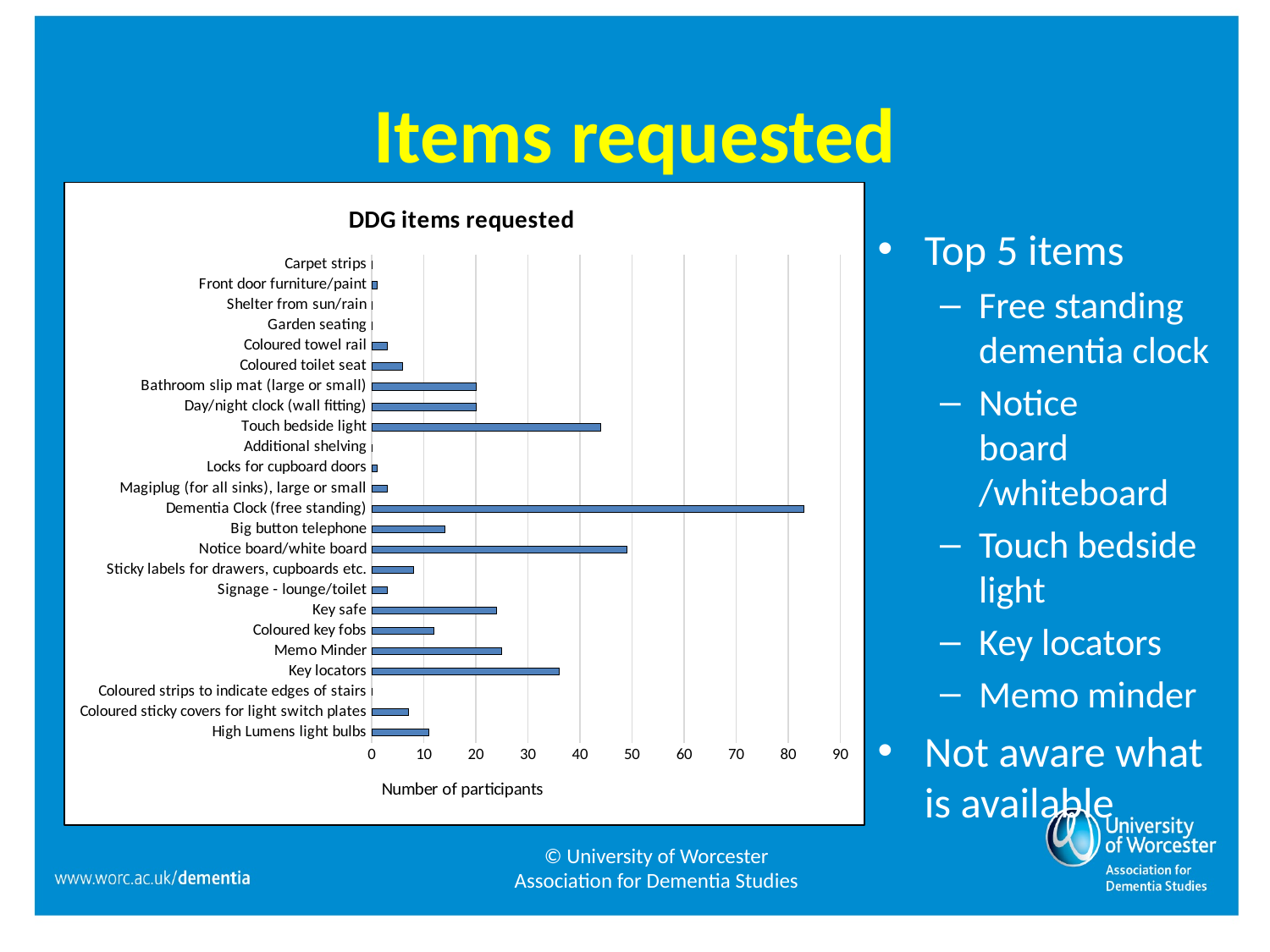
Which was requested by more participants, Dementia Clock (free standing) or Notice board/white board? Dementia Clock (free standing) Is the value for Touch bedside light greater or less than 50? less What is the label on the horizontal axis of the chart? Number of participants Which item was requested by the most participants? Dementia Clock (free standing) Is the value for Big button telephone greater or less than 20? less What kind of chart is shown on the slide? Bar chart Is the value for Key locators greater or less than 30? greater What is the title of the chart? DDG items requested How many items (categories) are listed on the chart? 24 Which was requested by more participants, Key locators or Memo Minder? Key locators